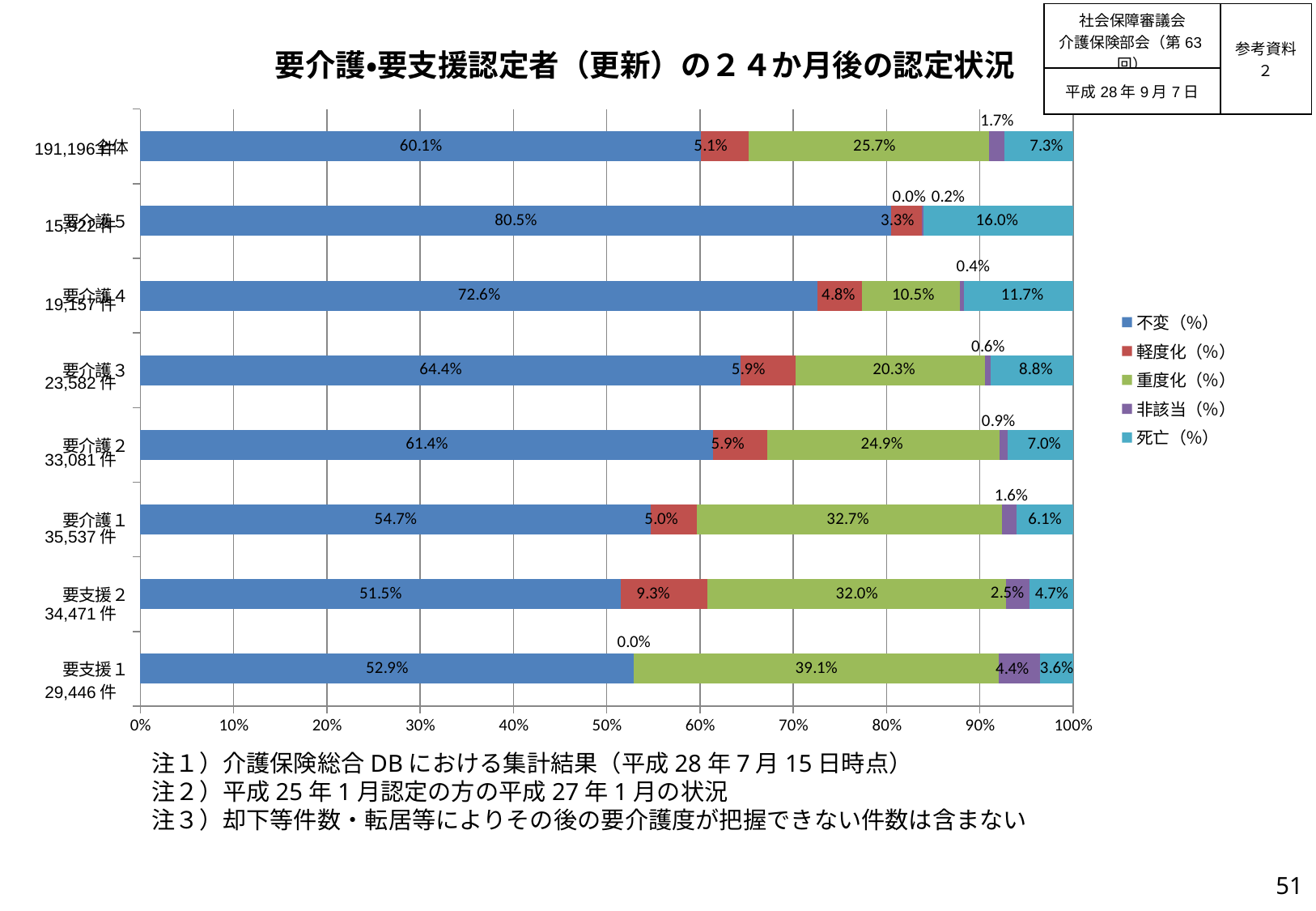
Which category has the lowest 死亡（%） value? 要支援１ What is the 重度化（%） value for 要支援１? 39.1% How many series does the legend list? 5 What is the 死亡（%） value for 全体? 7.3% What is the difference between the 死亡（%） values for 要介護５ and 要介護４? 4.3% What type of chart is shown on the slide? stacked bar chart Which category has the highest 軽度化（%） value? 要支援２ Which series is shown in blue in the legend? 不変（%） Which is larger, the 重度化（%） value for 要介護１ or for 要支援２? 要介護１ How many categories (bars) are plotted in the chart? 8 What is the 不変（%） value for 要介護５? 80.5% Which category has the highest 不変（%） value? 要介護５